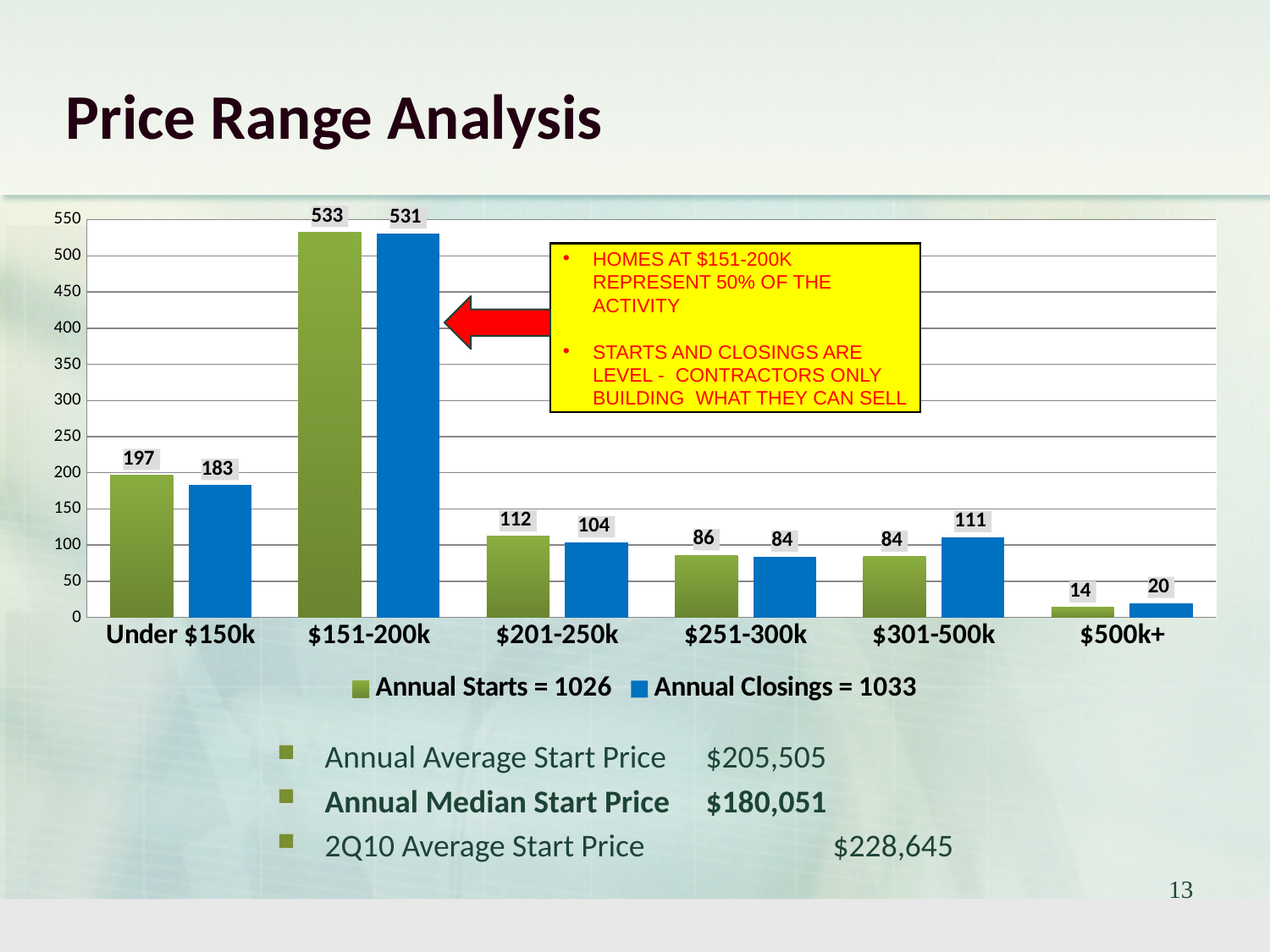
What colour represents Annual Closings in the chart? Blue What is the difference between Annual Starts for $151-200k and Annual Starts for $201-250k? 421 Which price range has the highest Annual Closings value? $151-200k Which is larger for the $301-500k price range, Annual Starts or Annual Closings? Annual Closings What is the value of Annual Starts for the Under $150k price range? 197 How many price range categories are shown on the x axis? 6 What is the difference between Annual Starts and Annual Closings for the Under $150k price range? 14 How many series does the legend list? 2 What is the value of Annual Starts for the $151-200k price range? 533 Which price range has the lowest Annual Starts value? $500k+ What kind of chart is shown on the slide? Bar chart What is the value of Annual Closings for the $301-500k price range? 111